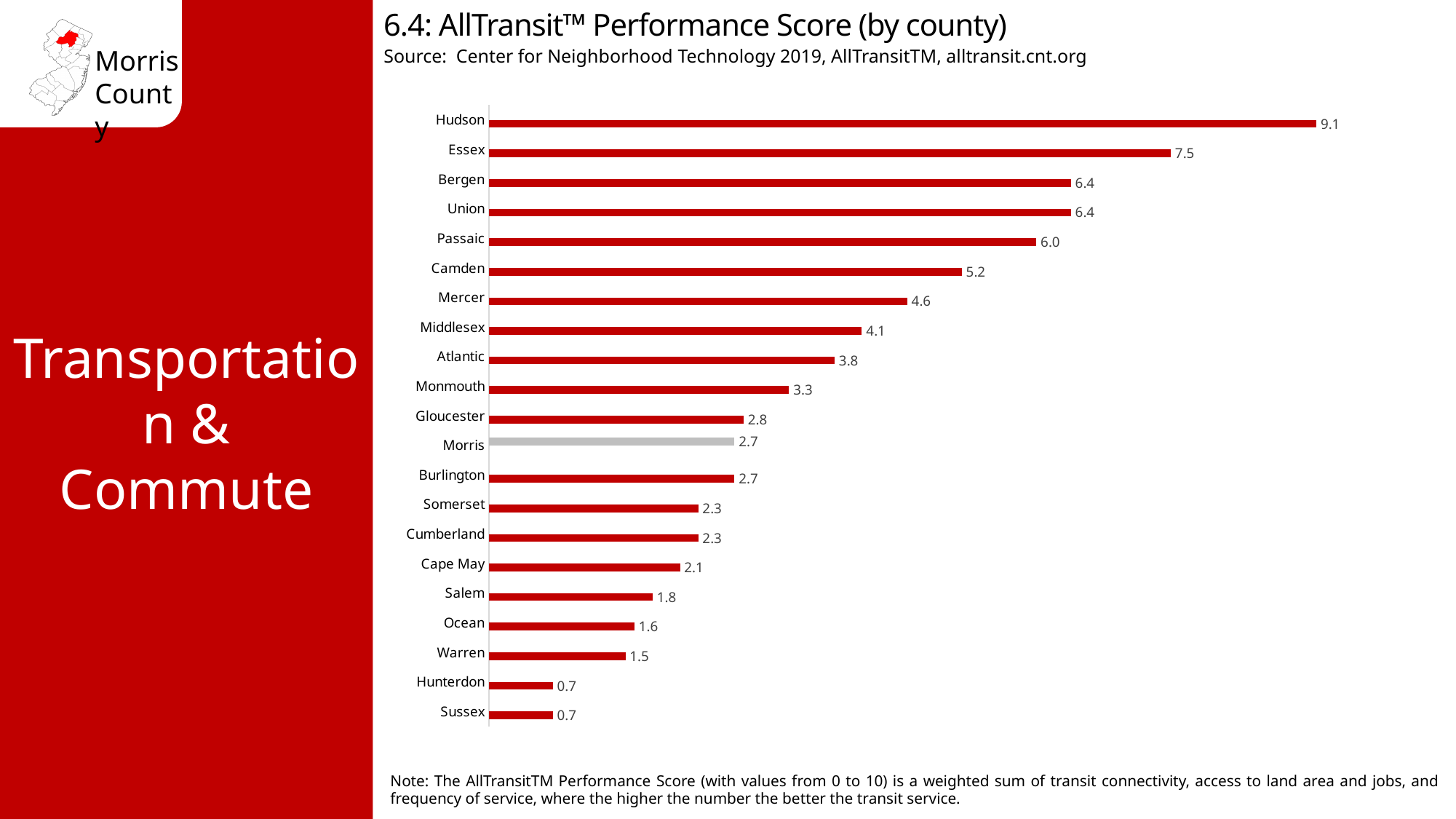
What is the AllTransit Performance Score for Passaic county? 6.0 Which county has the highest AllTransit Performance Score? Hudson Which county has a higher score, Monmouth or Gloucester? Monmouth What is the title of the chart? 6.4: AllTransit™ Performance Score (by county) How many counties are shown in the chart? 21 Which county has a higher score, Camden or Mercer? Camden What is the difference between the scores of Hudson and Essex? 1.6 What kind of chart is shown on the slide? Bar chart What is the AllTransit Performance Score for Morris county? 2.7 What is the AllTransit Performance Score for Hudson county? 9.1 Which county's bar is shown in grey rather than red? Morris What is the difference between the scores of Morris and Sussex? 2.0